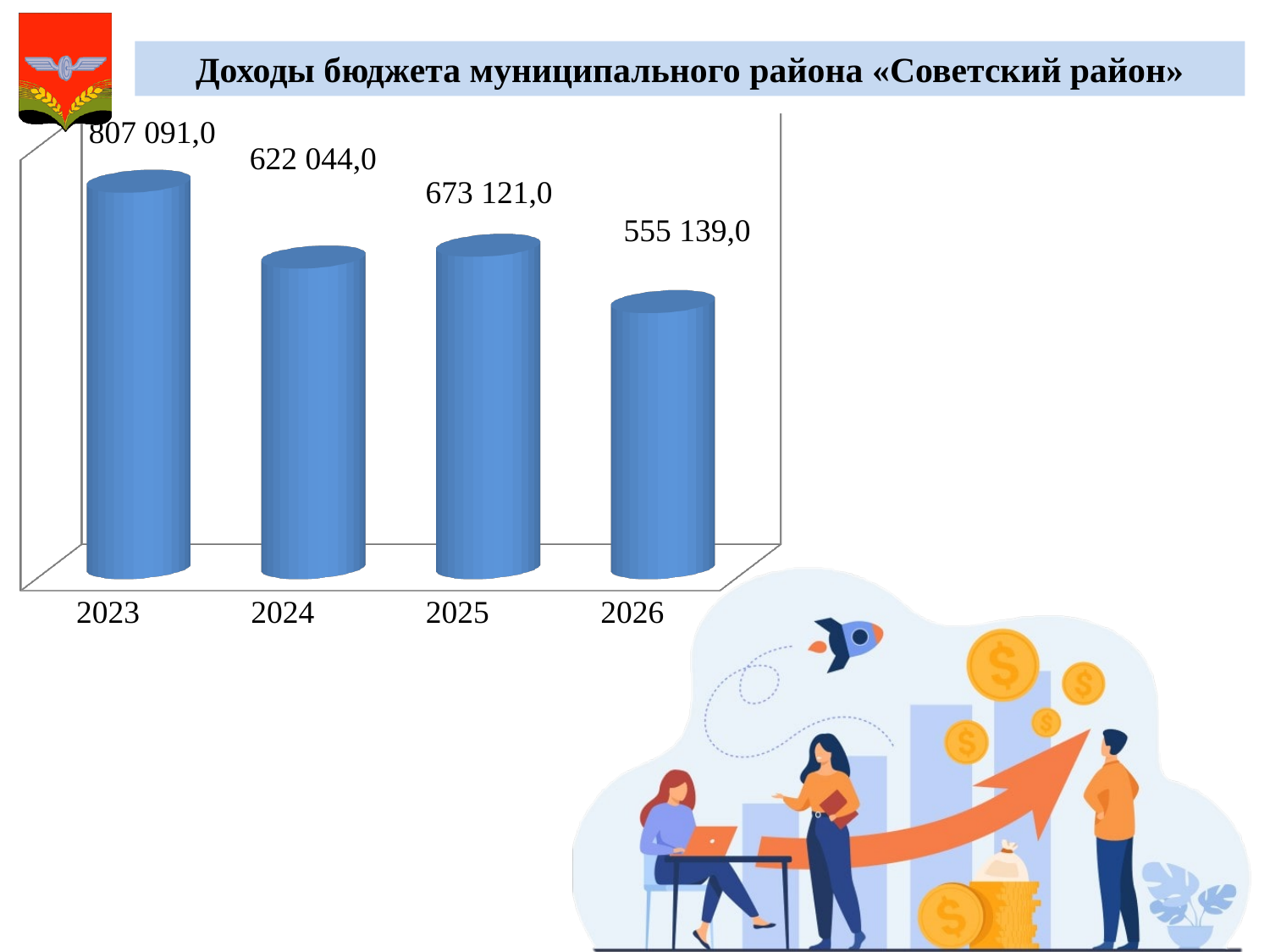
What kind of chart is shown on the slide? Bar chart Which year has the highest value? 2023 What is the value for 2023? 807 091,0 Which is larger, the value for 2024 or the value for 2025? 2025 What is the value for 2024? 622 044,0 What is the difference between the values for 2025 and 2026? 117 982,0 How many years are shown on the chart? 4 What is the value for 2026? 555 139,0 Which year has the lowest value? 2026 What is the title of the chart? Доходы бюджета муниципального района «Советский район» What is the value for 2025? 673 121,0 What is the difference between the values for 2023 and 2024? 185 047,0